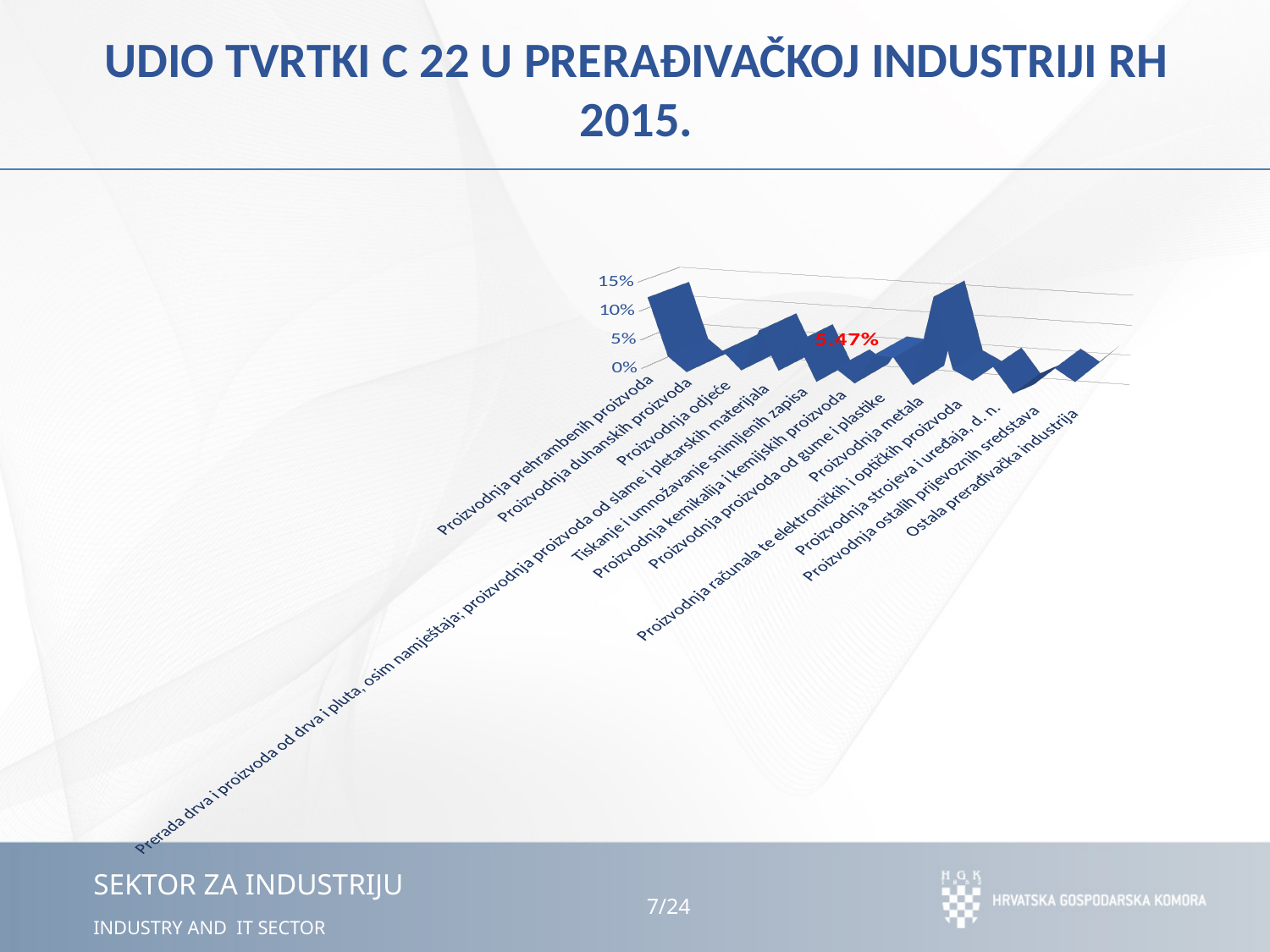
What is the title of the slide containing the chart? UDIO TVRTKI C 22 U PRERAĐIVAČKOJ INDUSTRIJI RH 2015. Which category on the chart carries the data label 5.47%? Proizvodnja proizvoda od gume i plastike Which category is the first one on the x axis of the chart? Proizvodnja prehrambenih proizvoda Is the value for Ostala prerađivačka industrija greater or less than 5%? less What kind of chart is shown on the slide? line chart What is the highest tick value shown on the vertical axis of the chart? 15% Is the value for Proizvodnja duhanskih proizvoda greater or less than 5%? less What value is labelled on the chart for Proizvodnja proizvoda od gume i plastike? 5.47% Is the value for Proizvodnja prehrambenih proizvoda greater or less than 5%? greater Which is larger, the value for Proizvodnja prehrambenih proizvoda or the value for Proizvodnja odjeće? Proizvodnja prehrambenih proizvoda